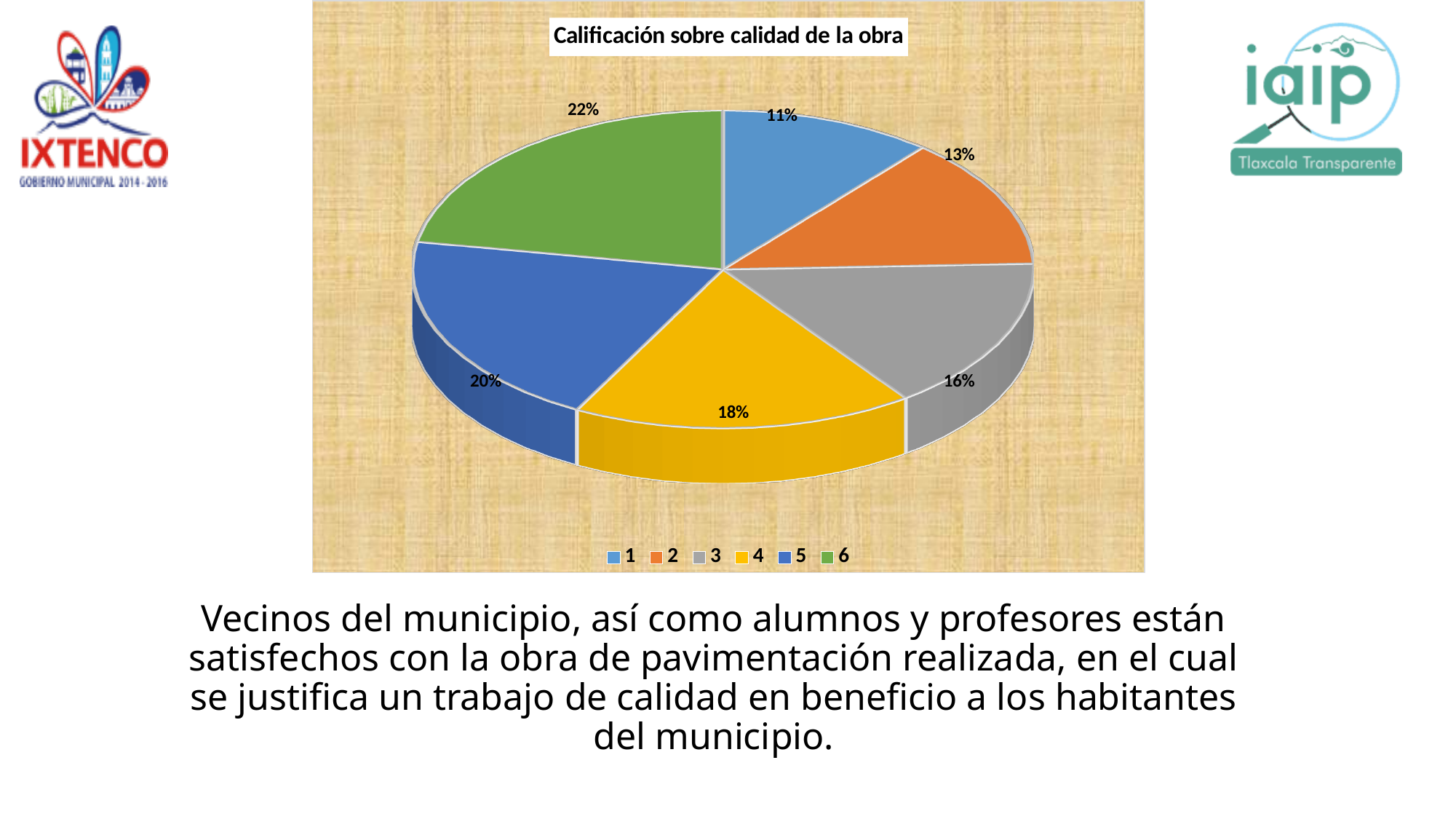
What percentage is shown for category 2? 13% What percentage is shown for category 1? 11% What is the title of the chart? Calificación sobre calidad de la obra Which category has the smallest share of the pie? 1 What percentage is shown for category 6? 22% What kind of chart is shown on the slide? Pie chart How many categories does the legend list? 6 What percentage is shown for category 4? 18% What is the difference in percentage points between category 6 and category 1? 11 Which is larger, the share for category 5 or the share for category 3? 5 What colour is the slice for category 4? Yellow Which category has the largest share of the pie? 6